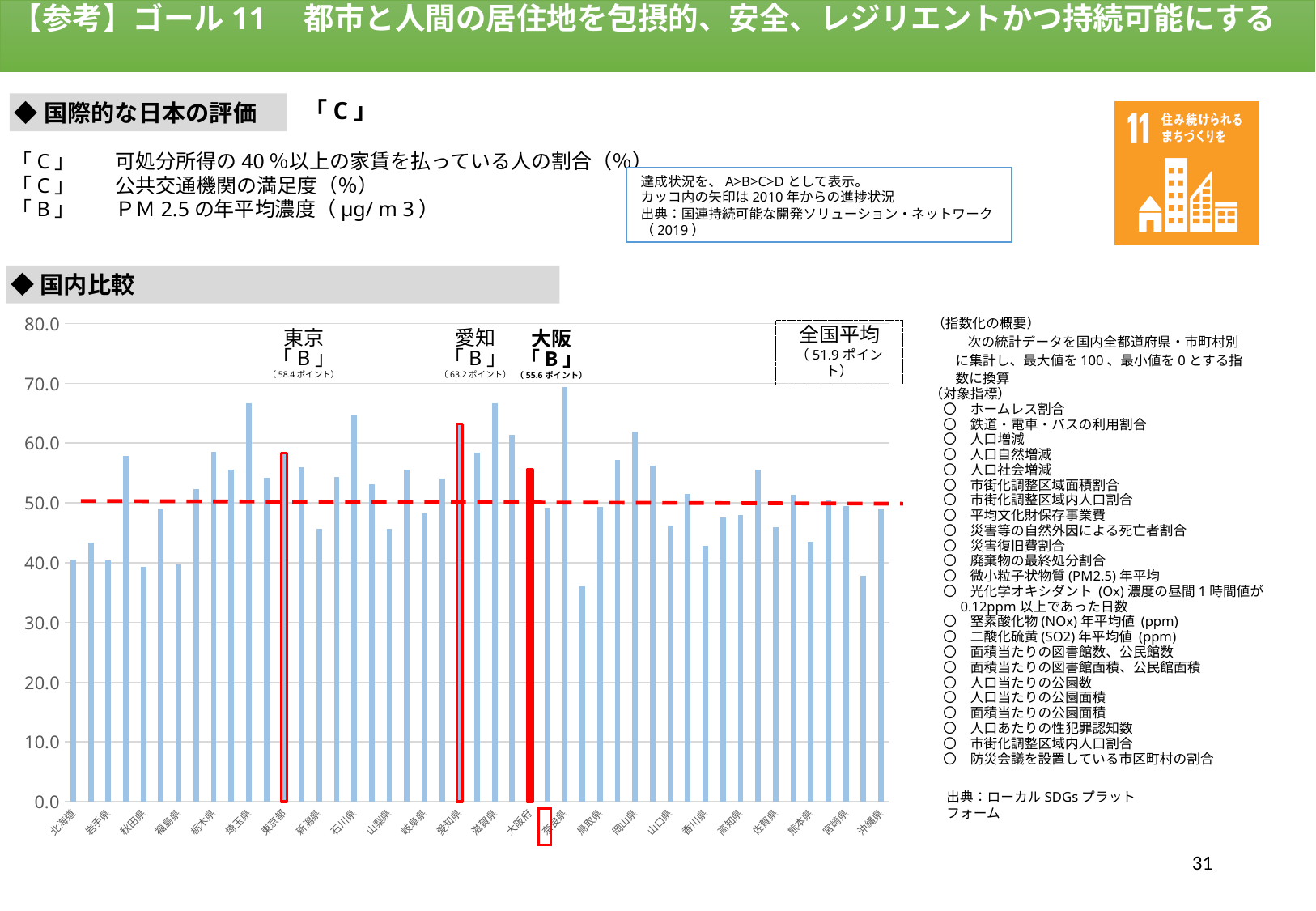
How far above the 全国平均 is 愛知 on the 国内比較 chart? 11.3 What kind of chart is used in the 国内比較 section? bar chart Is the value for 北海道 on the 国内比較 chart greater or less than 50? less What is the 全国平均 value shown on the 国内比較 chart? 51.9 ポイント Which has the higher value on the 国内比較 chart, 東京 or 愛知? 愛知 By how many points does 愛知 exceed 東京 on the 国内比較 chart? 4.8 What value is printed for 大阪 on the 国内比較 chart? 55.6 ポイント What does the red dashed horizontal line on the 国内比較 chart represent? 全国平均 What value is printed for 東京 on the 国内比較 chart? 58.4 ポイント What value is printed for 愛知 on the 国内比較 chart? 63.2 ポイント Is the value for 鳥取県 on the 国内比較 chart greater or less than 40? greater What is the difference between the 東京 value and the 大阪 value on the 国内比較 chart? 2.8